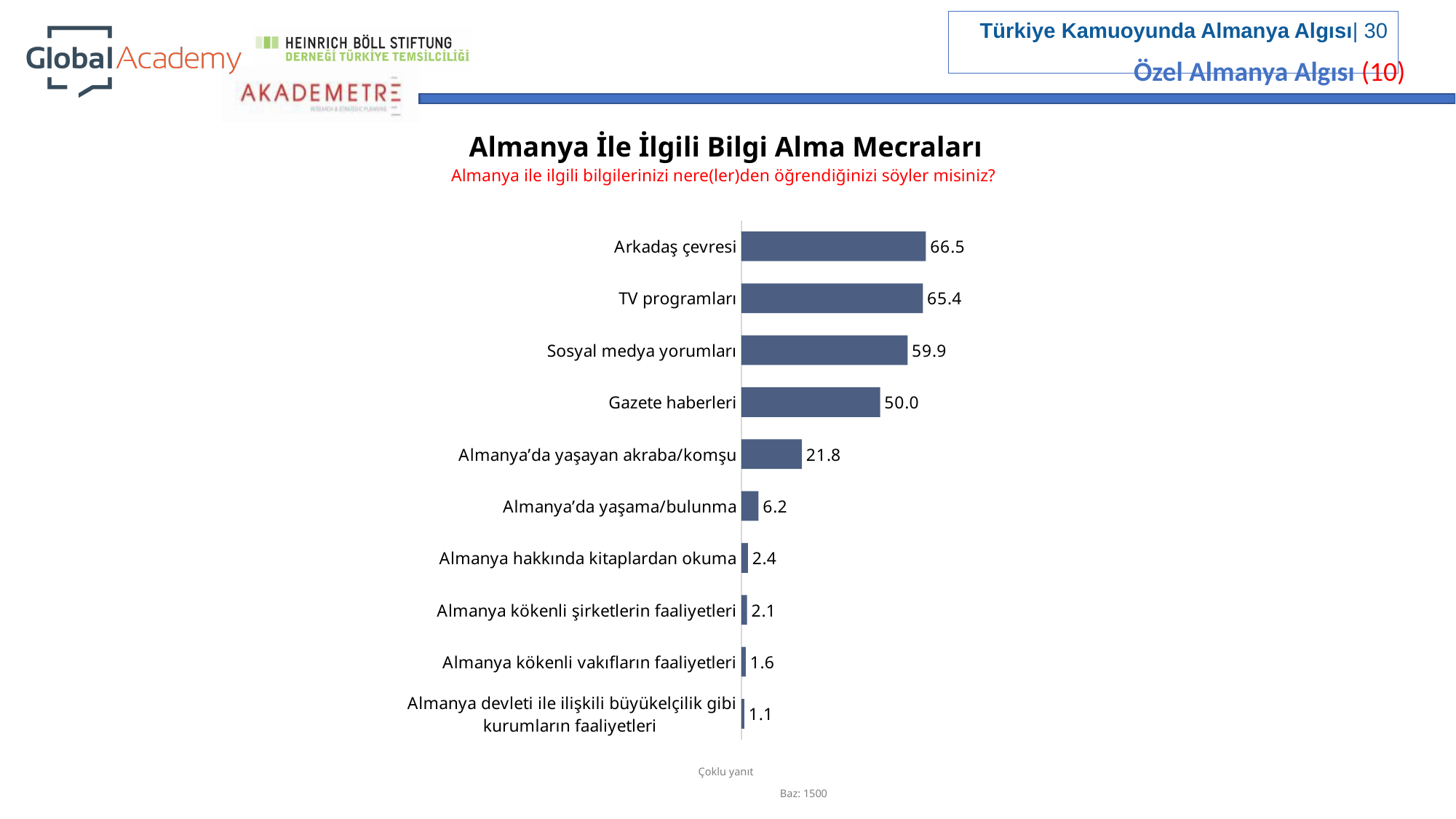
What is the value for "TV programları"? 65.4 Which category has the highest value? Arkadaş çevresi What is the base (Baz) sample size noted below the chart? 1500 What is the value for "Almanya kökenli vakıfların faaliyetleri"? 1.6 What is the difference between the values for "Sosyal medya yorumları" and "Gazete haberleri"? 9.9 What kind of chart is shown on the slide? Bar chart What is the title of the chart? Almanya İle İlgili Bilgi Alma Mecraları What is the value for "Almanya'da yaşayan akraba/komşu"? 21.8 Which category has the lowest value? Almanya devleti ile ilişkili büyükelçilik gibi kurumların faaliyetleri How many categories are shown in the chart? 10 What is the value for "Gazete haberleri"? 50.0 Which is larger: the value for "Almanya'da yaşama/bulunma" or the value for "Almanya hakkında kitaplardan okuma"? Almanya'da yaşama/bulunma